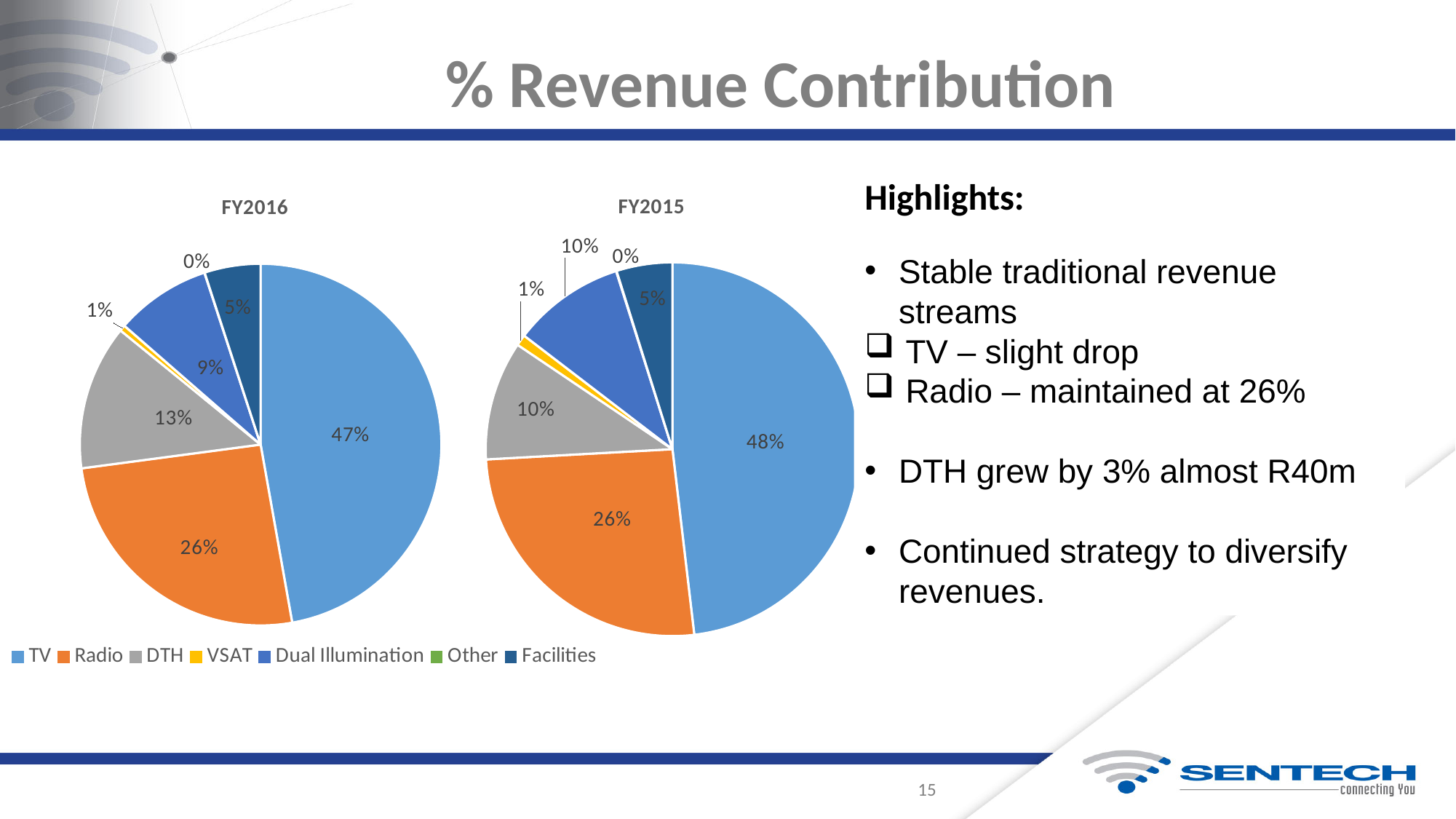
In the FY2015 pie chart, which is larger, the share for Radio or the share for DTH? Radio How many series does the legend list for the pie charts? 7 What kind of chart is used to show the FY2016 revenue contribution? Pie chart In the FY2015 pie chart, what is the share for DTH? 10% In the FY2016 pie chart, what is the share for DTH? 13% In the FY2016 pie chart, which category has the largest share? TV In the FY2015 pie chart, which category has the largest share? TV In the FY2016 pie chart, what is the share for Dual Illumination? 9% What is the title of the chart on the left? FY2016 In the FY2015 pie chart, what share of revenue does TV contribute? 48% In the FY2016 pie chart, what is the difference between the TV share and the Radio share? 21% In the FY2016 pie chart, what share of revenue does TV contribute? 47%